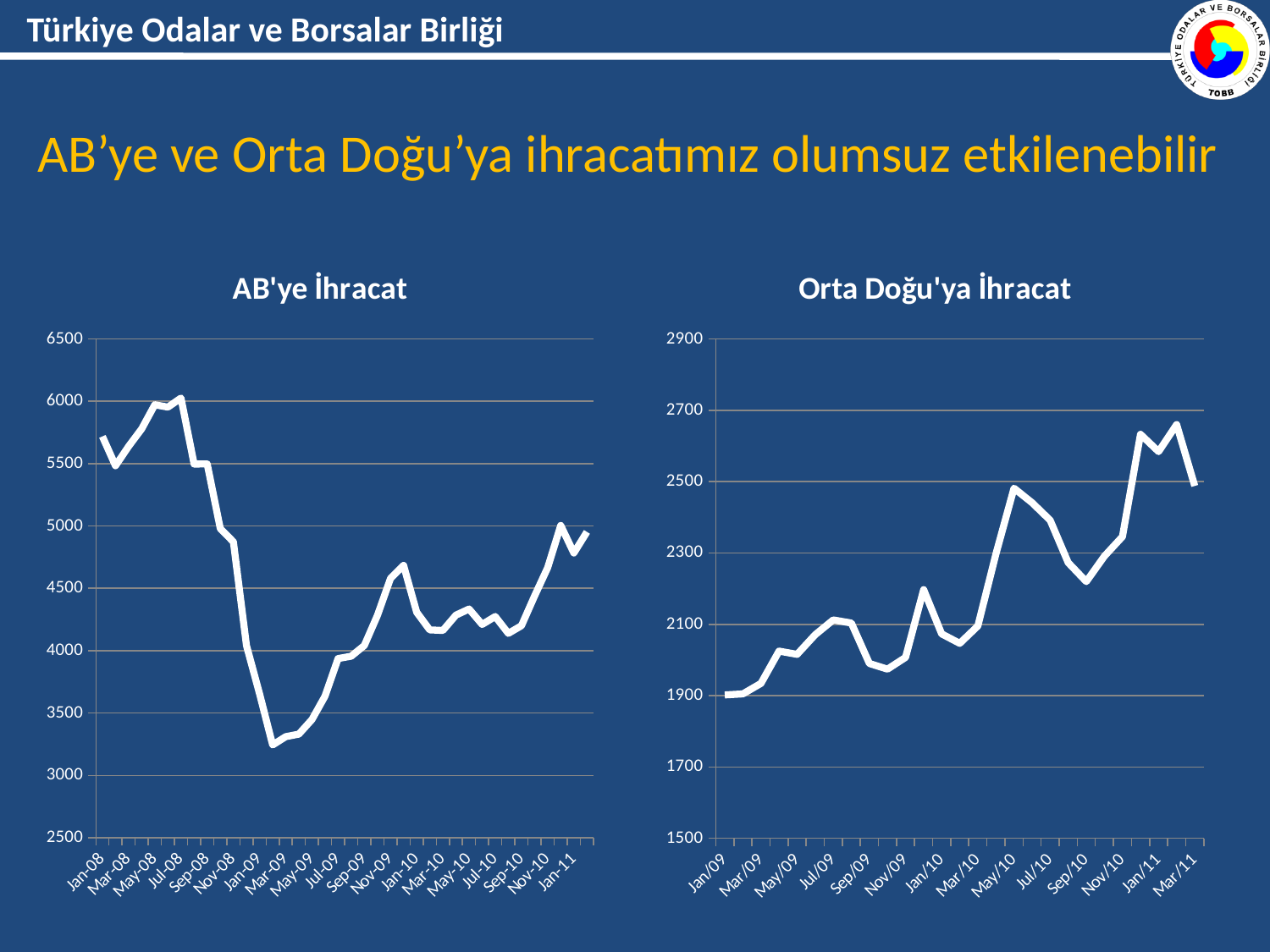
In the 'AB'ye İhracat' chart, is the value for Jul-08 greater or less than 5500? greater In the 'Orta Doğu'ya İhracat' chart, do the values overall rise or fall from Jan/09 to Jan/11? rise In the 'AB'ye İhracat' chart, is the value for Jan-10 greater or less than 4500? less What is the title of the chart on the right side of the slide? Orta Doğu'ya İhracat In the 'AB'ye İhracat' chart, do the values rise or fall between Jul-08 and Mar-09? fall In the 'Orta Doğu'ya İhracat' chart, is the value for Sep/10 greater or less than 2500? less What type of chart is the 'Orta Doğu'ya İhracat' chart? line chart What type of chart is the 'AB'ye İhracat' chart? line chart